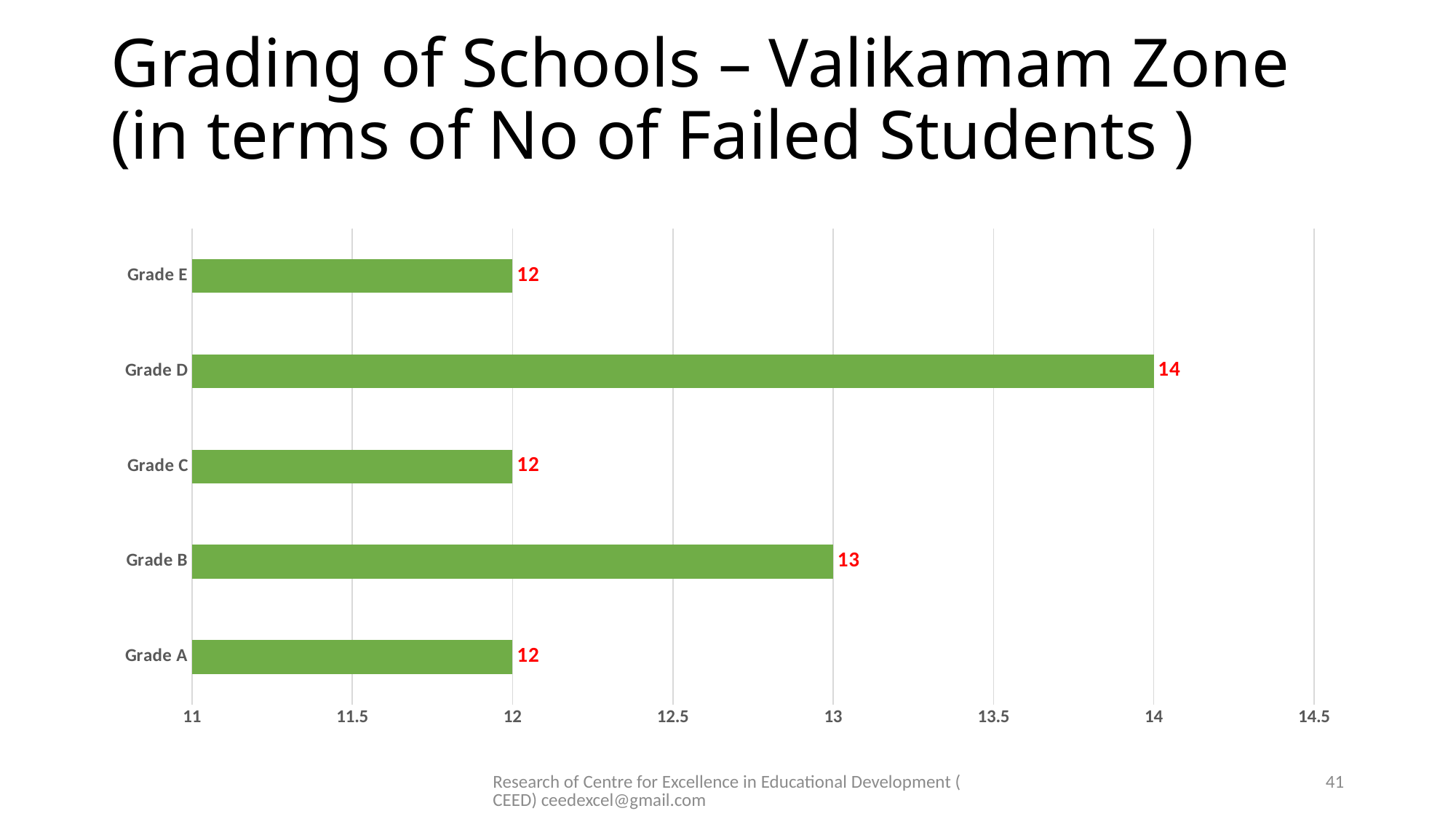
What is the value for Grade A? 12 What colour are the bars in the chart? green What is the difference between the values for Grade D and Grade E? 2 What is the value for Grade D? 14 Which is larger, the value for Grade B or the value for Grade C? Grade B Which grade has the highest value? Grade D What is the difference between the values for Grade D and Grade B? 1 Is the value for Grade D greater or less than 13? greater What is the value for Grade B? 13 How many grade categories are shown in the chart? 5 What kind of chart is shown on the slide? bar chart How many grades have a value of 12? 3